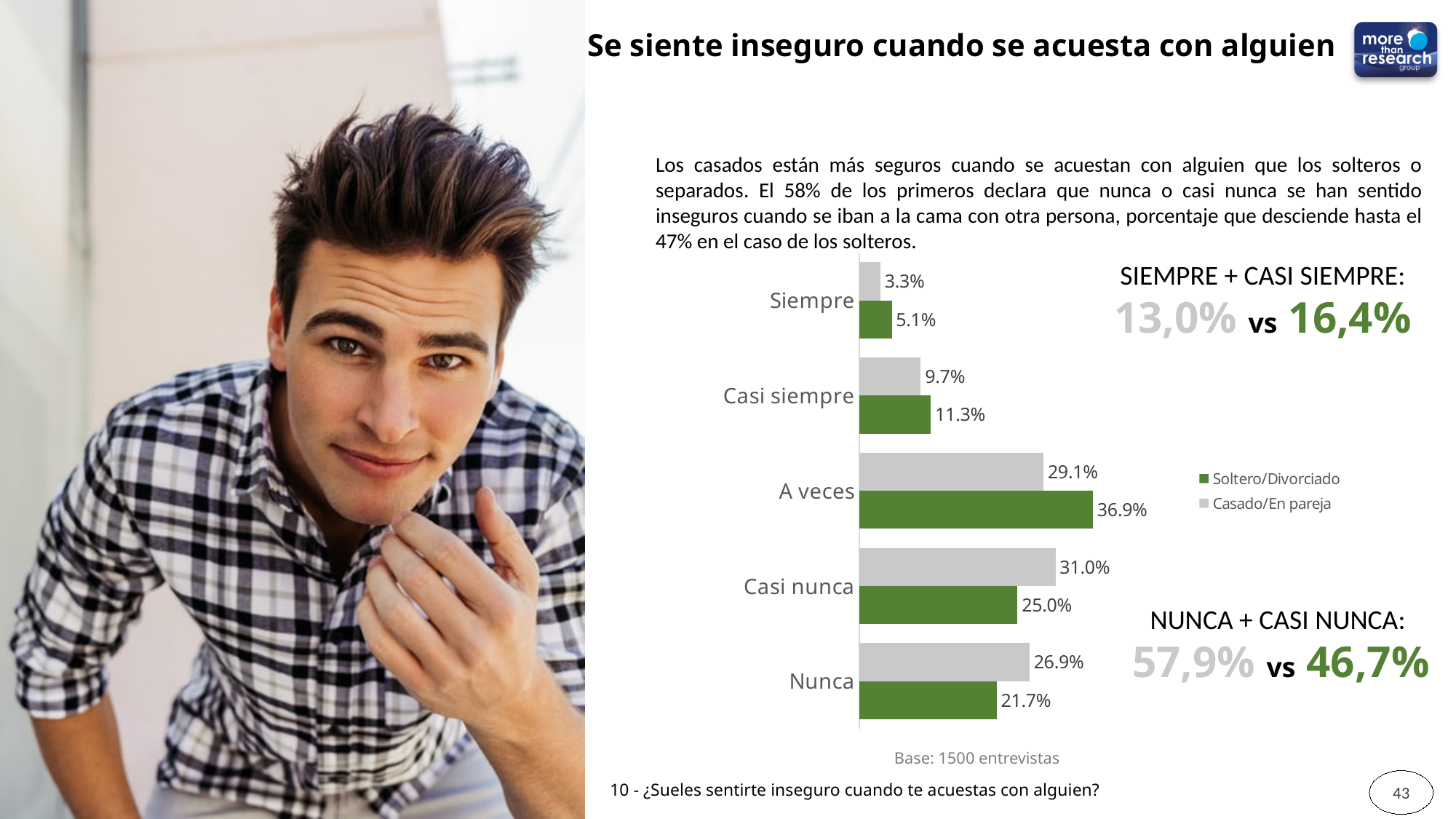
How many categories are shown on the chart? 5 What is the value for Soltero/Divorciado in the 'Nunca' category? 21.7% What kind of chart is shown on the slide? Bar chart What is the difference between the Soltero/Divorciado and Casado/En pareja values in the 'A veces' category? 7.8% Which category has the lowest value for Casado/En pareja? Siempre Which category has the highest value for Soltero/Divorciado? A veces How many series does the chart legend list? 2 What is the value for Casado/En pareja in the 'Siempre' category? 3.3% In the 'Casi nunca' category, which series has the larger value, Soltero/Divorciado or Casado/En pareja? Casado/En pareja What is the value for Soltero/Divorciado in the 'A veces' category? 36.9% What is the value for Casado/En pareja in the 'Casi nunca' category? 31.0% Which colour represents the Casado/En pareja series in the chart? Grey